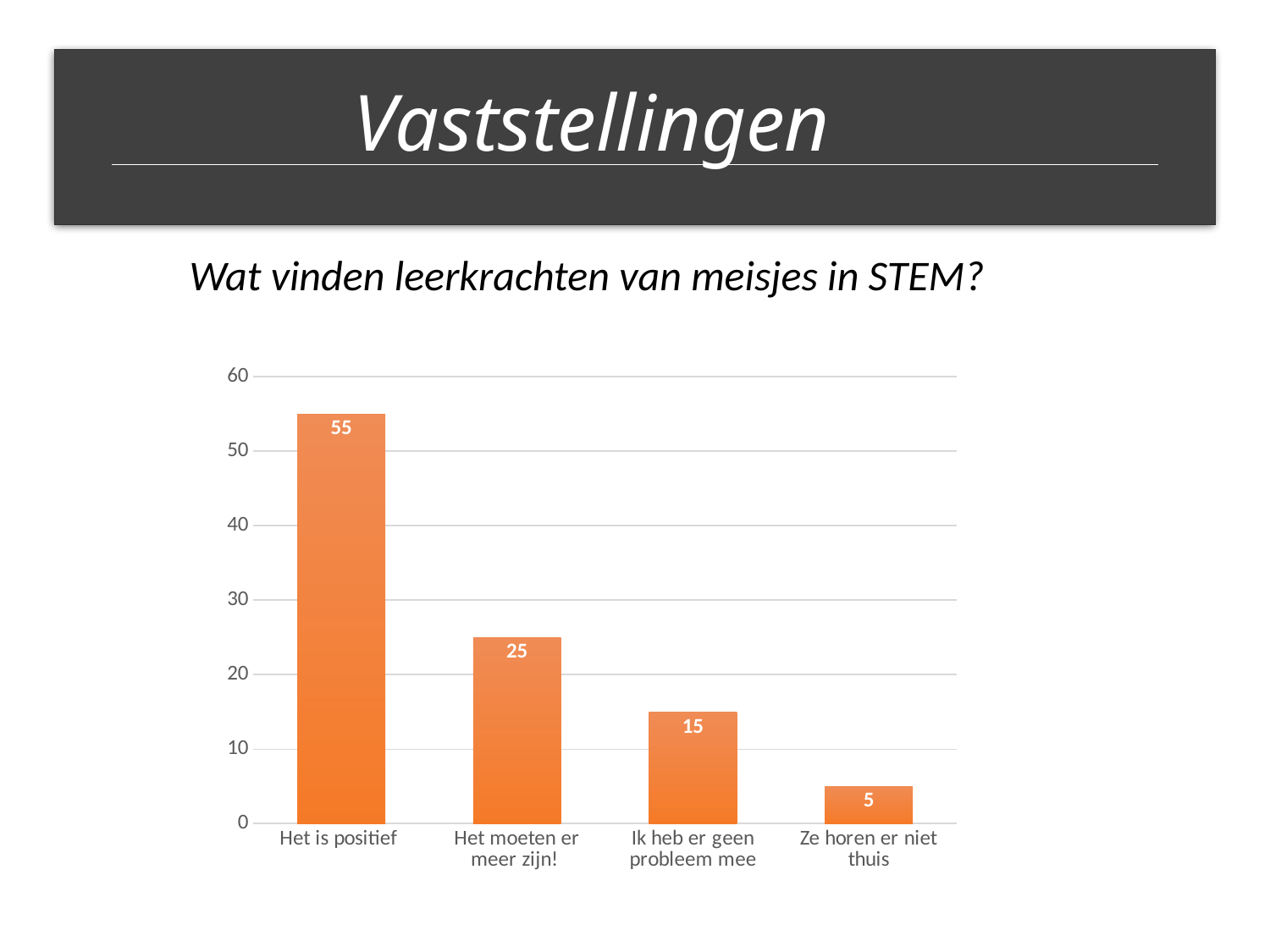
Which is larger, the value for "Ik heb er geen probleem mee" or the value for "Ze horen er niet thuis"? Ik heb er geen probleem mee Is the value for "Het is positief" greater or less than 50? greater What is the value for "Het is positief"? 55 Do the values rise or fall from left to right along the x axis? fall Which category has the highest value? Het is positief What is the value for "Ze horen er niet thuis"? 5 What is the value for "Ik heb er geen probleem mee"? 15 How many categories are shown in the chart? 4 Which category has the lowest value? Ze horen er niet thuis What is the difference between the values for "Het is positief" and "Het moeten er meer zijn!"? 30 What kind of chart is shown on the slide? bar chart What is the value for "Het moeten er meer zijn!"? 25